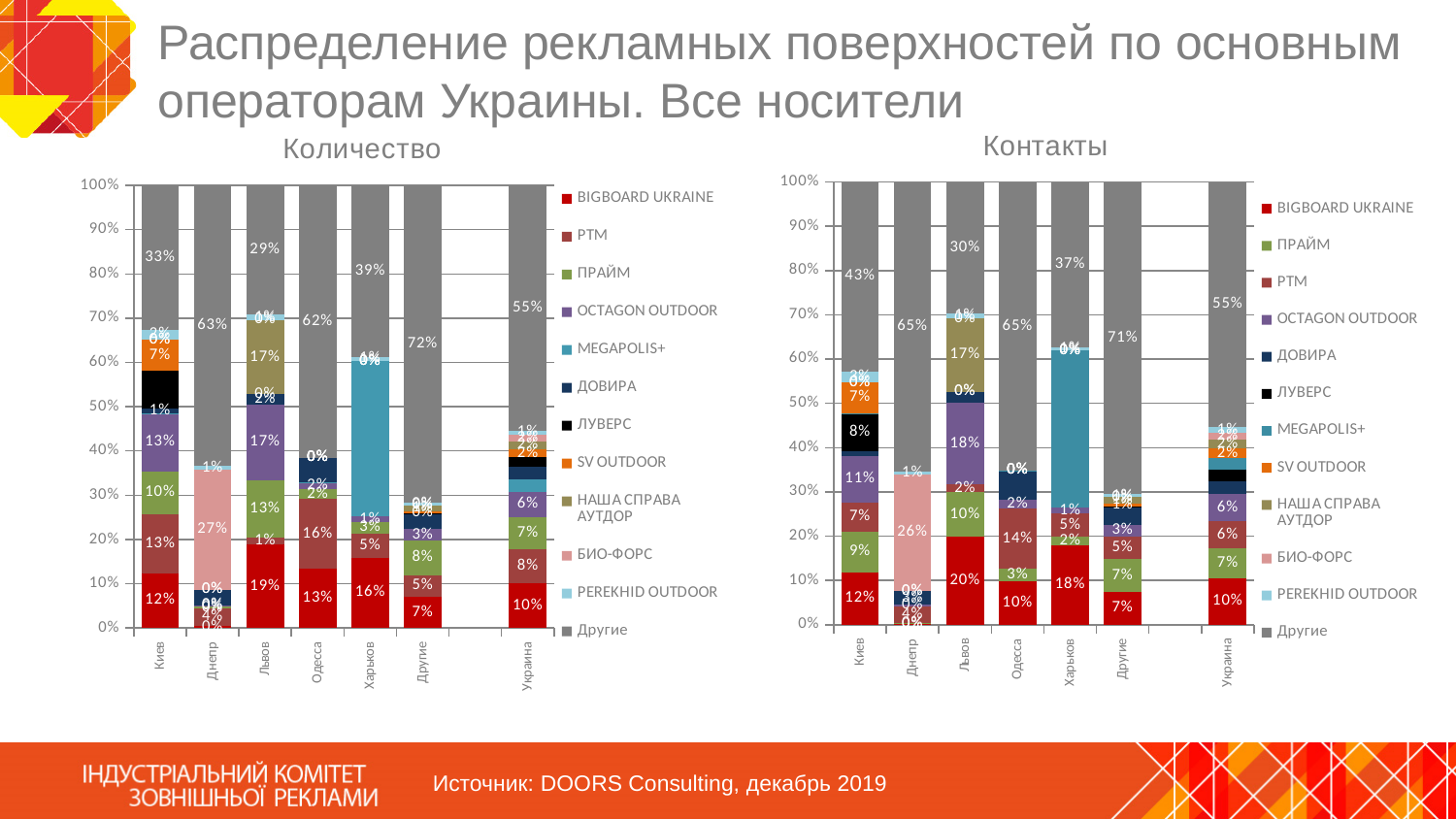
In the "Контакты" chart, what is the share of Другие for Украина? 55% How many categories are shown on the x axis of the "Контакты" chart? 7 By how many percentage points does the Другие share for Киев in the "Контакты" chart exceed the Другие share for Киев in the "Количество" chart? 10 percentage points In the "Контакты" chart, what is the share of BIGBOARD UKRAINE for Львов? 20% How many series does the legend of the "Количество" chart list? 12 In the "Контакты" chart, what is the share of OCTAGON OUTDOOR for Львов? 18% What kind of chart is the "Количество" chart? Stacked bar chart In the "Контакты" chart, which category has the largest BIGBOARD UKRAINE share? Львов In the "Контакты" chart, is the Другие share larger for Львов or for Харьков? Харьков In the "Количество" chart, what is the share of БИО-ФОРС for Днепр? 27% What source is cited at the bottom of the slide? DOORS Consulting, декабрь 2019 In the "Количество" chart, what is the share of Другие for Днепр? 63%